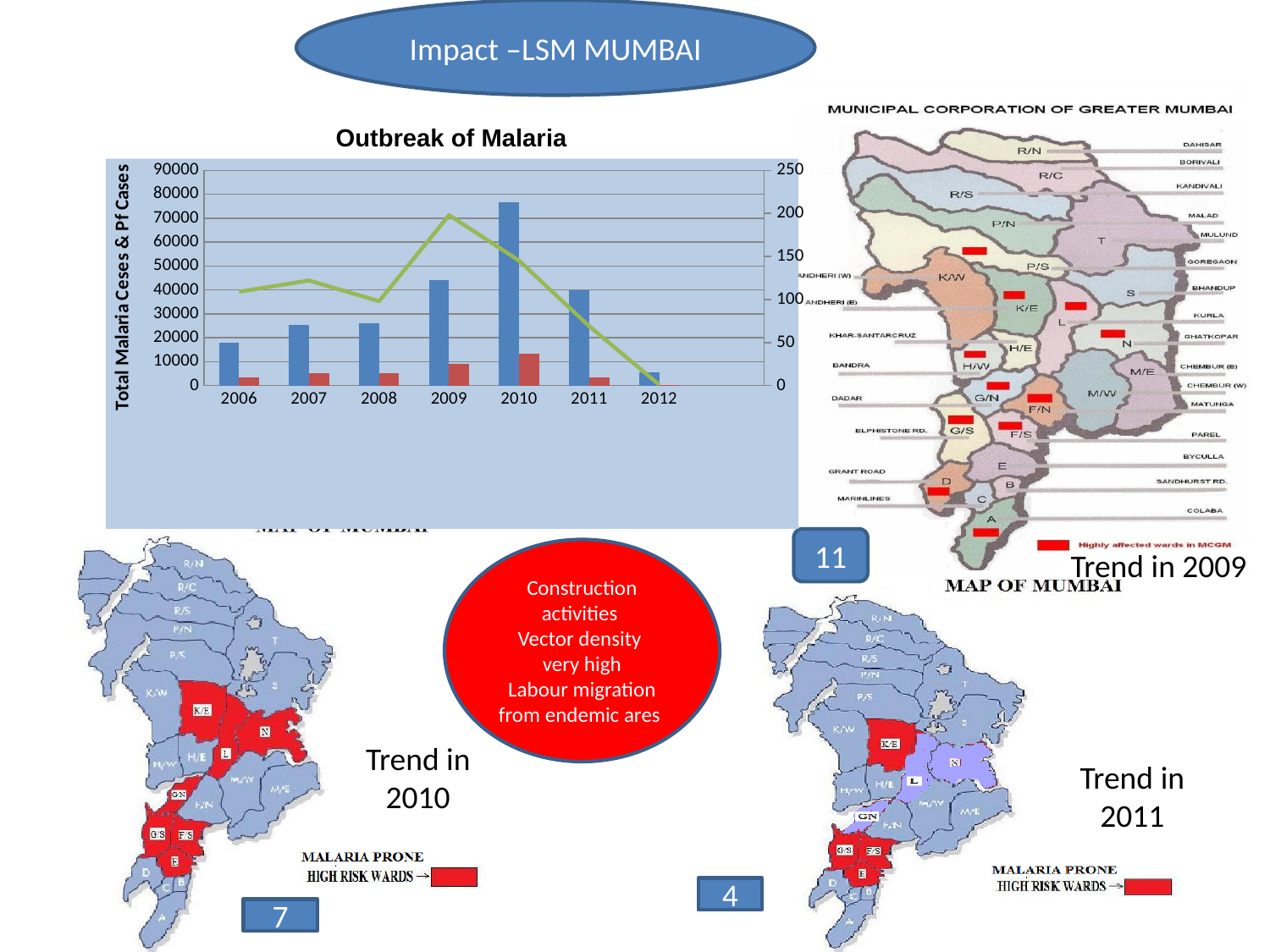
What is the title of the chart on the slide? Outbreak of Malaria In the 'Outbreak of Malaria' chart, is the blue bar for 2009 greater or less than 40000? greater In the 'Outbreak of Malaria' chart, which year has the tallest red bar? 2010 How many years are shown on the x axis of the 'Outbreak of Malaria' chart? 7 In the 'Outbreak of Malaria' chart, in which year does the green line reach its peak? 2009 In the 'Outbreak of Malaria' chart, does the green line rise or fall from 2010 to 2012? fall In the 'Outbreak of Malaria' chart, which year has the tallest blue bar? 2010 In the 'Outbreak of Malaria' chart, is the blue bar for 2006 greater or less than 20000? less In the 'Outbreak of Malaria' chart, which year has the shortest blue bar? 2012 In the 'Outbreak of Malaria' chart, is the blue bar for 2010 greater or less than 70000? greater What kind of chart is the 'Outbreak of Malaria' chart? bar chart with a line In the 'Outbreak of Malaria' chart, is the blue bar for 2010 taller than the blue bar for 2009? yes